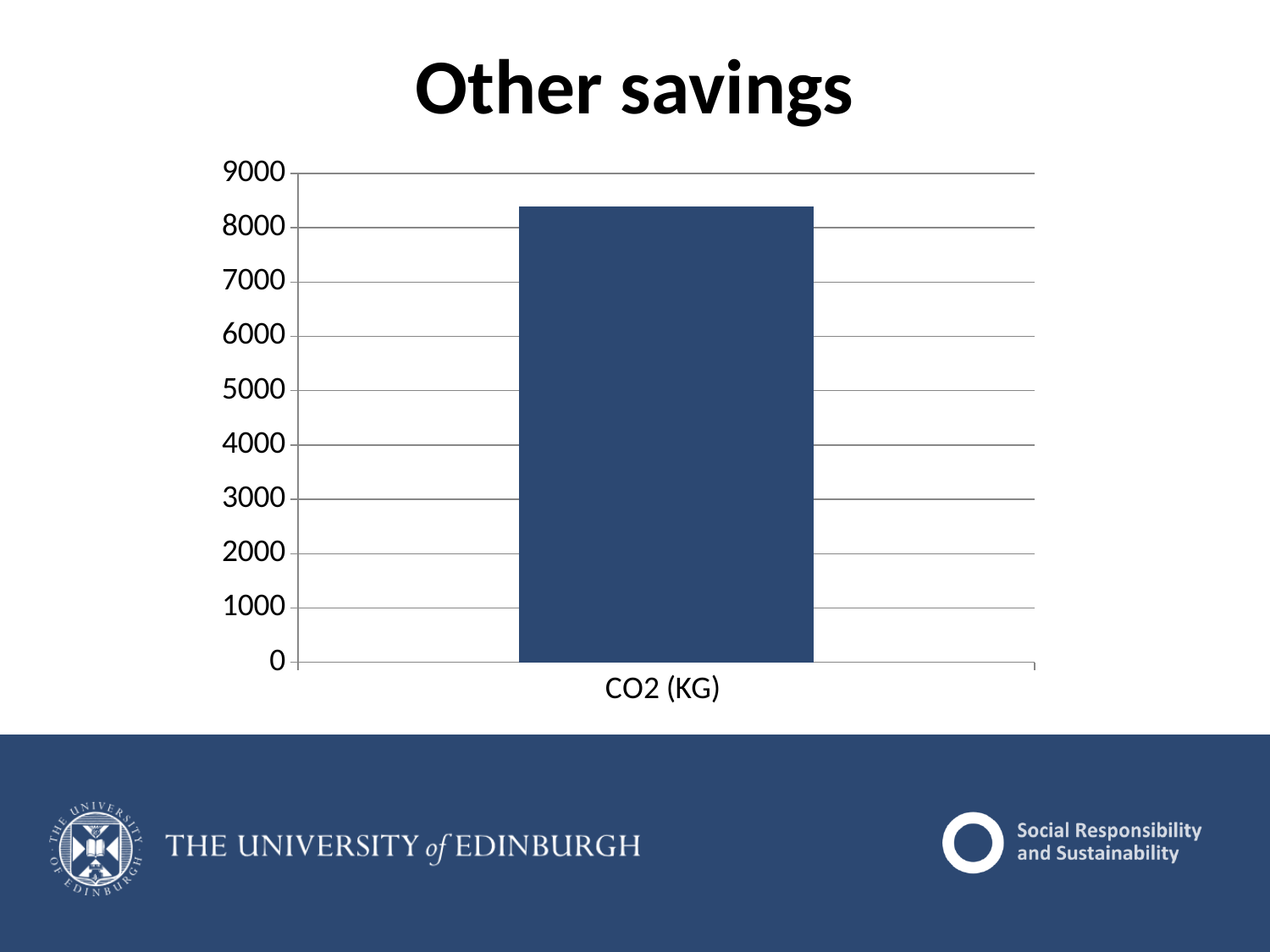
What is the category label on the x axis of the chart? CO2 (KG) What is the highest value shown on the y axis of the chart? 9000 Is the value for CO2 (KG) greater or less than 8000? greater Is the value for CO2 (KG) greater or less than 9000? less Is the value for CO2 (KG) greater or less than 5000? greater What is the title of the chart on the slide? Other savings What kind of chart is shown on the slide? bar chart How many bars does the chart show? 1